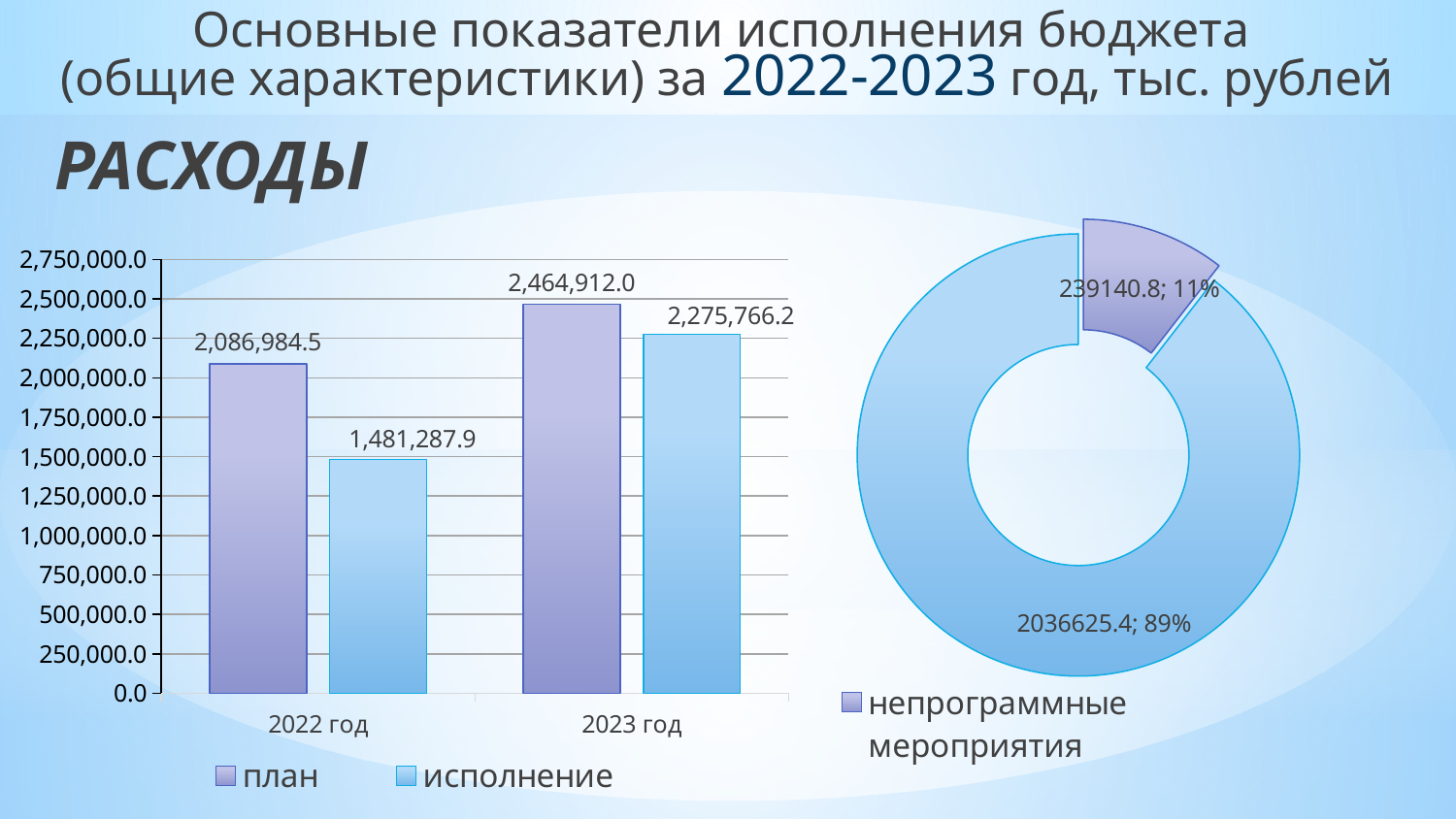
In the doughnut chart on the right, what share of the total does непрограммные мероприятия represent? 11% In the doughnut chart on the right, what is the value of the slice labelled 89%? 2036625.4 In the bar chart on the left, what is the difference between план and исполнение for 2022 год? 605,696.6 In the bar chart on the left, what is the value of исполнение for 2022 год? 1,481,287.9 In the bar chart on the left, which bar has the lowest value? исполнение, 2022 год In the bar chart on the left, which bar has the highest value? план, 2023 год In the bar chart on the left, what is the difference between план for 2023 год and план for 2022 год? 377,927.5 In the bar chart on the left, what is the value of исполнение for 2023 год? 2,275,766.2 In the bar chart on the left, what is the value of план for 2022 год? 2,086,984.5 In the bar chart on the left, does the value of исполнение rise or fall from 2022 год to 2023 год? rise In the bar chart on the left, which is larger: исполнение for 2023 год or план for 2022 год? исполнение for 2023 год In the bar chart on the left, how many series does the legend list? 2